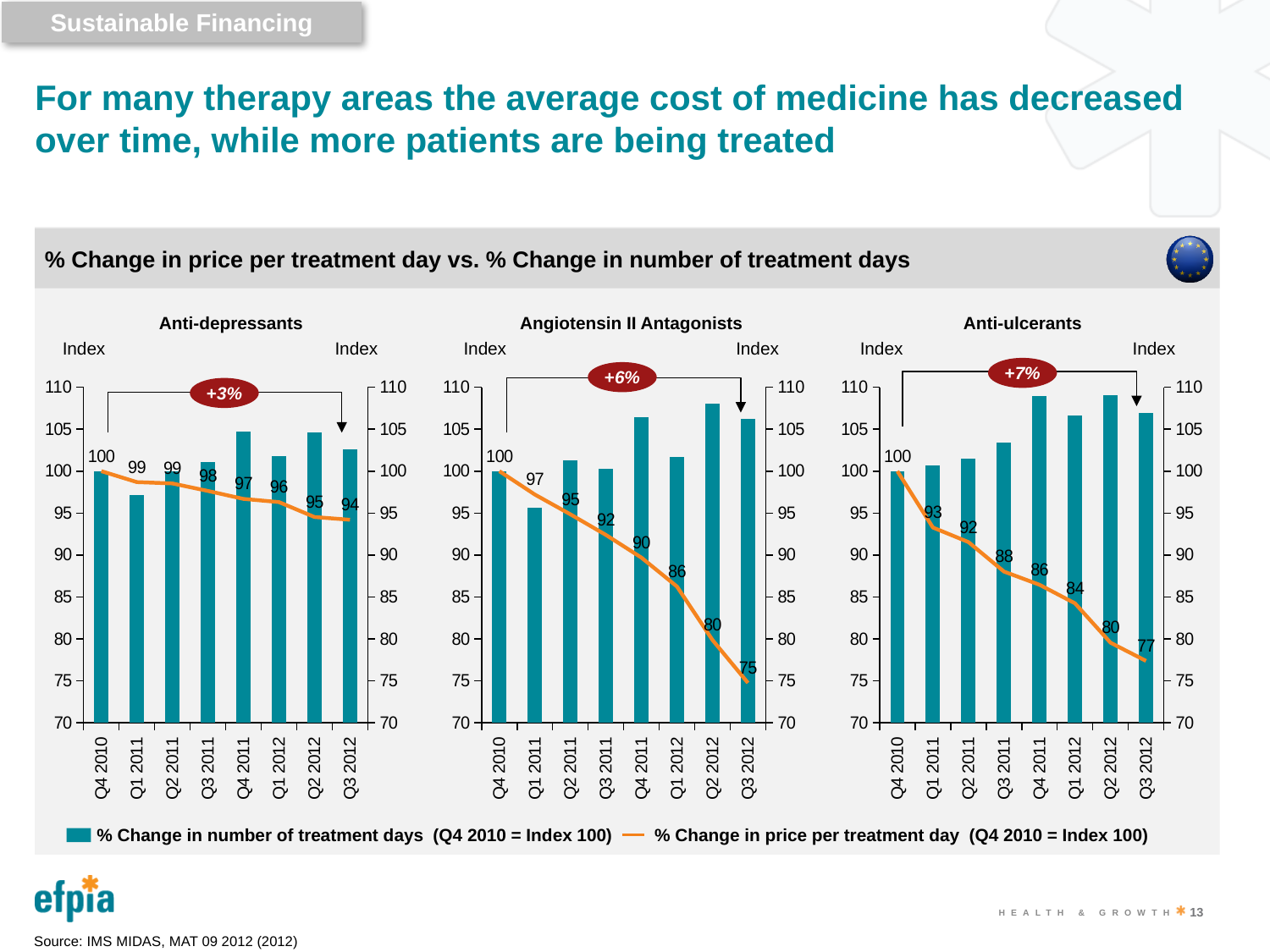
In the Anti-ulcerants chart, is the number of treatment days bar for Q4 2011 greater or less than 105? greater In the Anti-depressants chart, what is the index value of the price per treatment day line in Q3 2012? 94 In the Anti-depressants chart, is the price per treatment day index in Q3 2011 higher or lower than in Q1 2012? higher What percentage change is annotated above the bars in the Anti-ulcerants chart? +7% In the Anti-ulcerants chart, what is the index value of the price per treatment day line in Q3 2012? 77 In the Angiotensin II Antagonists chart, does the price per treatment day line rise or fall from Q4 2010 to Q3 2012? fall In the Anti-ulcerants chart, what is the difference between the price per treatment day index in Q1 2011 and Q2 2012? 13 How many quarters are shown on the x axis of the Anti-ulcerants chart? 8 In the Angiotensin II Antagonists chart, what is the index value of the price per treatment day line in Q1 2012? 86 In the Angiotensin II Antagonists chart, is the number of treatment days bar for Q1 2011 greater or less than 100? less In the Anti-depressants chart, which quarter has the lowest price per treatment day index? Q3 2012 In the Angiotensin II Antagonists chart, by how many index points did the price per treatment day line fall from Q4 2010 to Q3 2012? 25